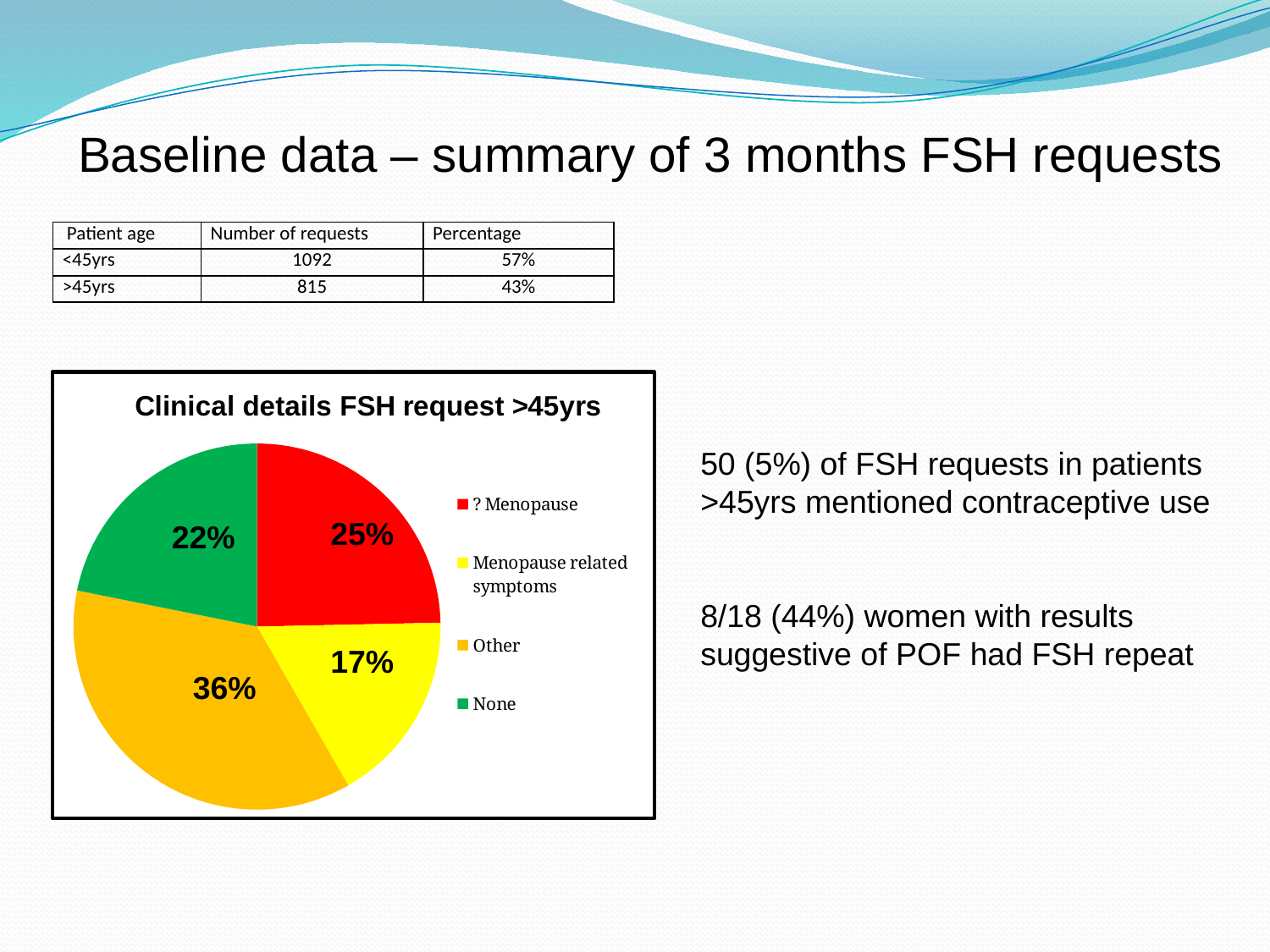
What is the title of the pie chart? Clinical details FSH request >45yrs What is the difference in percentage points between the 'Other' slice and the 'None' slice? 14 What percentage of the pie chart is 'Other'? 36% What type of chart is shown on the slide? pie chart What percentage of the pie chart is 'Menopause related symptoms'? 17% Which slice is larger, '? Menopause' or 'None'? ? Menopause Which category has the largest slice in the pie chart? Other What colour is the 'None' slice in the pie chart? green Which category has the smallest slice in the pie chart? Menopause related symptoms What percentage of the pie chart is 'None'? 22% How many categories does the pie chart show? 4 What percentage of the pie chart is labelled '? Menopause'? 25%